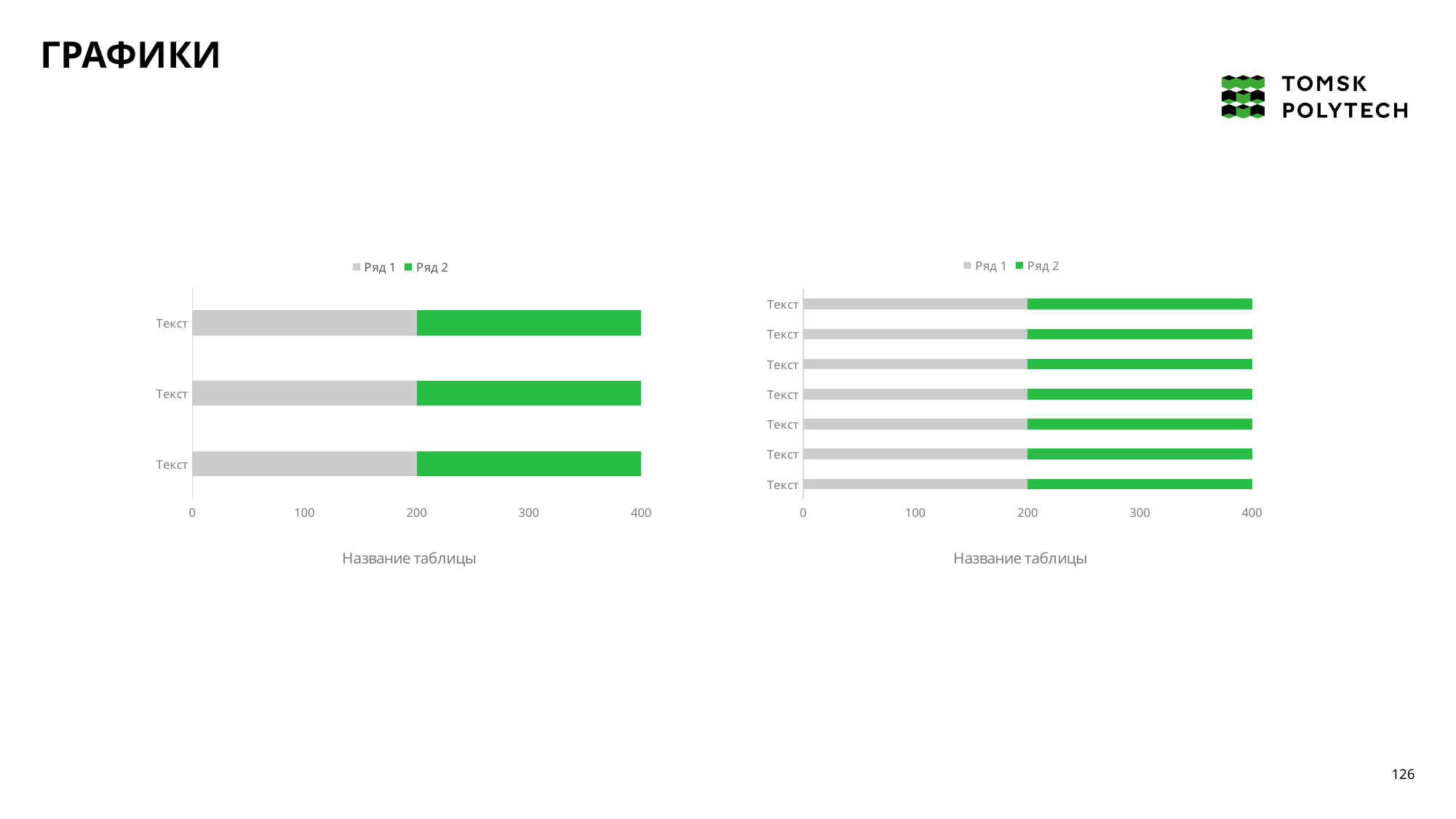
In the left chart, is the value of Ряд 1 for the bottom bar greater or less than 100? greater How many categories are plotted in the right chart? 7 In the left chart, which colour represents Ряд 2? Green In the right chart, is the total of the top stacked bar greater or less than 300? greater What kind of chart is the chart on the left side of the slide? Stacked bar chart How many categories are plotted in the left chart? 3 In the right chart, what is the total of the bottom stacked bar? 400 In the left chart, what is the total of the top stacked bar? 400 How many series does the legend of the left chart list? 2 In the right chart, what is the value of Ряд 2 for the top bar? 200 In the left chart, what is the value of Ряд 1 for the top bar? 200 What are the legend entries of the right chart? Ряд 1, Ряд 2